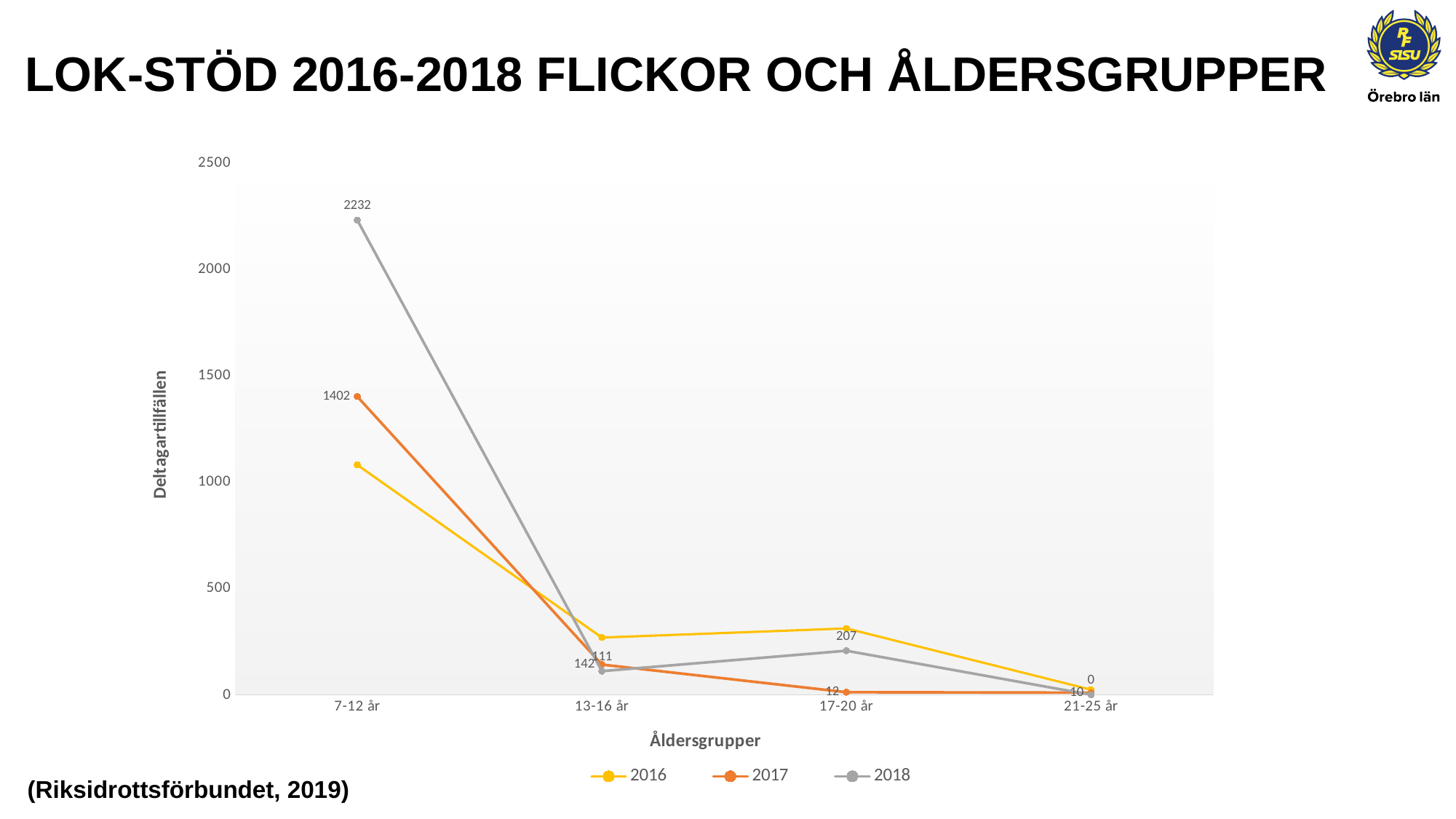
What is the value for 2017 in the 7-12 år age group? 1402 In which age group does the 2018 series reach its highest value? 7-12 år What kind of chart is shown on the slide? line chart How many age groups are shown on the x axis? 4 What is the value for 2017 in the 17-20 år age group? 12 Which series has the lowest value in the 17-20 år age group? 2017 What is the difference between the 2018 and 2017 values in the 7-12 år age group? 830 Which series has the higher value in the 7-12 år age group, 2017 or 2018? 2018 How many series does the legend list? 3 What is the title of the y axis? Deltagartillfällen Is the value for 2016 in the 7-12 år age group greater or less than 1000? greater What is the value for 2018 in the 7-12 år age group? 2232